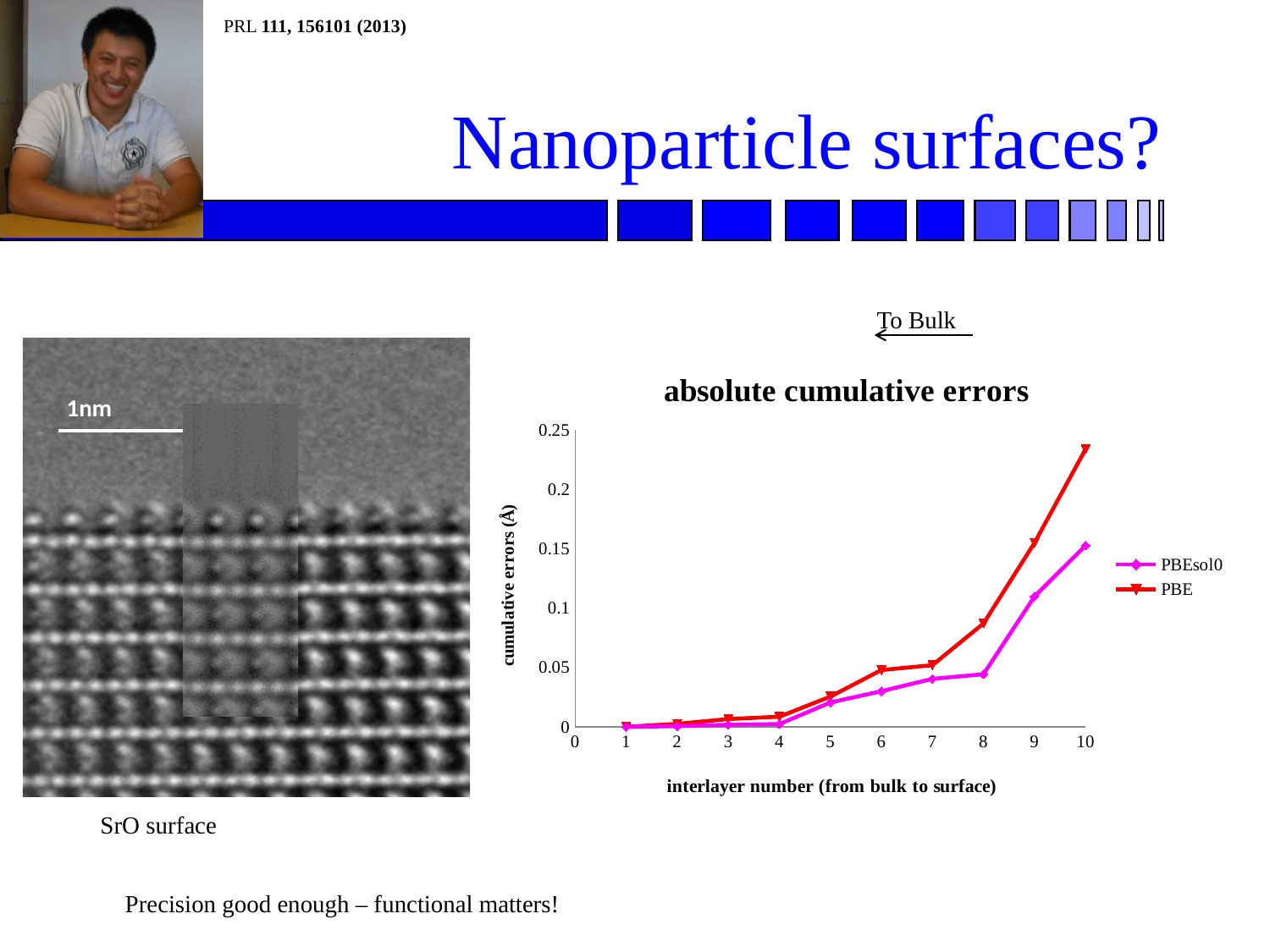
At interlayer number 10, which series has the larger cumulative error, PBE or PBEsol0? PBE How many series does the legend of the chart list? 2 What are the two series named in the chart legend? PBEsol0 and PBE Is the PBEsol0 value at interlayer number 10 greater or less than 0.2? less At which interlayer number does the PBE series reach its highest cumulative error? 10 Is the PBE value at interlayer number 9 greater or less than 0.1? greater Is the PBE value at interlayer number 8 greater or less than 0.1? less What kind of chart is shown on the slide? line chart What is the title of the chart? absolute cumulative errors Do the cumulative errors rise or fall as the interlayer number increases from 1 to 10? rise How many interlayer numbers are plotted for each series in the chart? 10